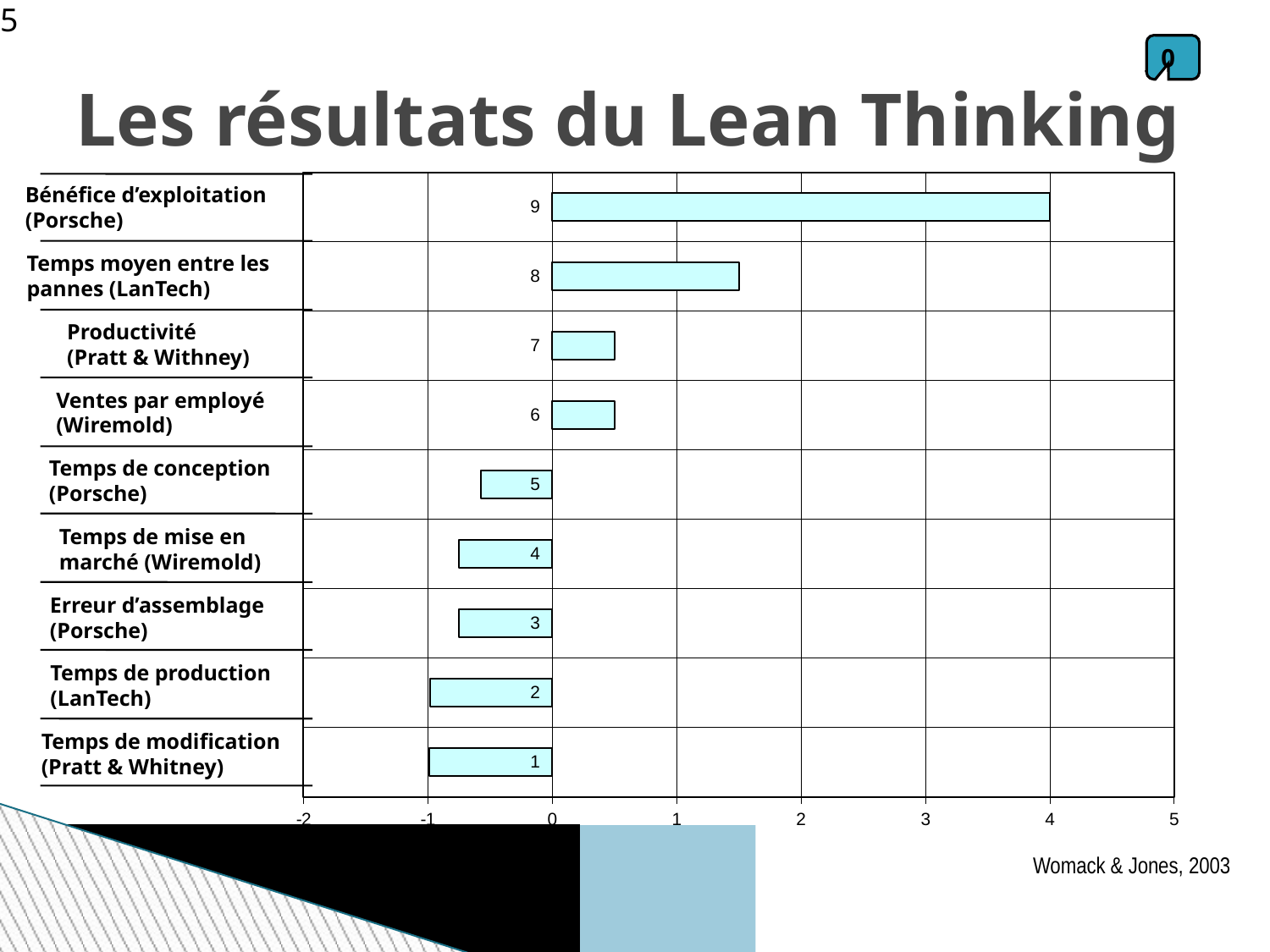
What is the title of the slide containing the chart? Les résultats du Lean Thinking Which is larger, the value for Bénéfice d'exploitation (Porsche) or the value for Temps moyen entre les pannes (LanTech)? Bénéfice d'exploitation (Porsche) Which is larger, the value for Ventes par employé (Wiremold) or the value for Temps de mise en marché (Wiremold)? Ventes par employé (Wiremold) What value does the bar for Bénéfice d'exploitation (Porsche) reach on the x axis? 4 Is the value for Temps de conception (Porsche) greater or less than 0? less Is the value for Productivité (Pratt & Withney) greater or less than 1? less What source is cited below the chart? Womack & Jones, 2003 What kind of chart is shown on the slide? bar chart Which category has the highest value in the chart? Bénéfice d'exploitation (Porsche) How many categories are plotted in the chart? 9 Is the value for Temps moyen entre les pannes (LanTech) greater or less than 1? greater